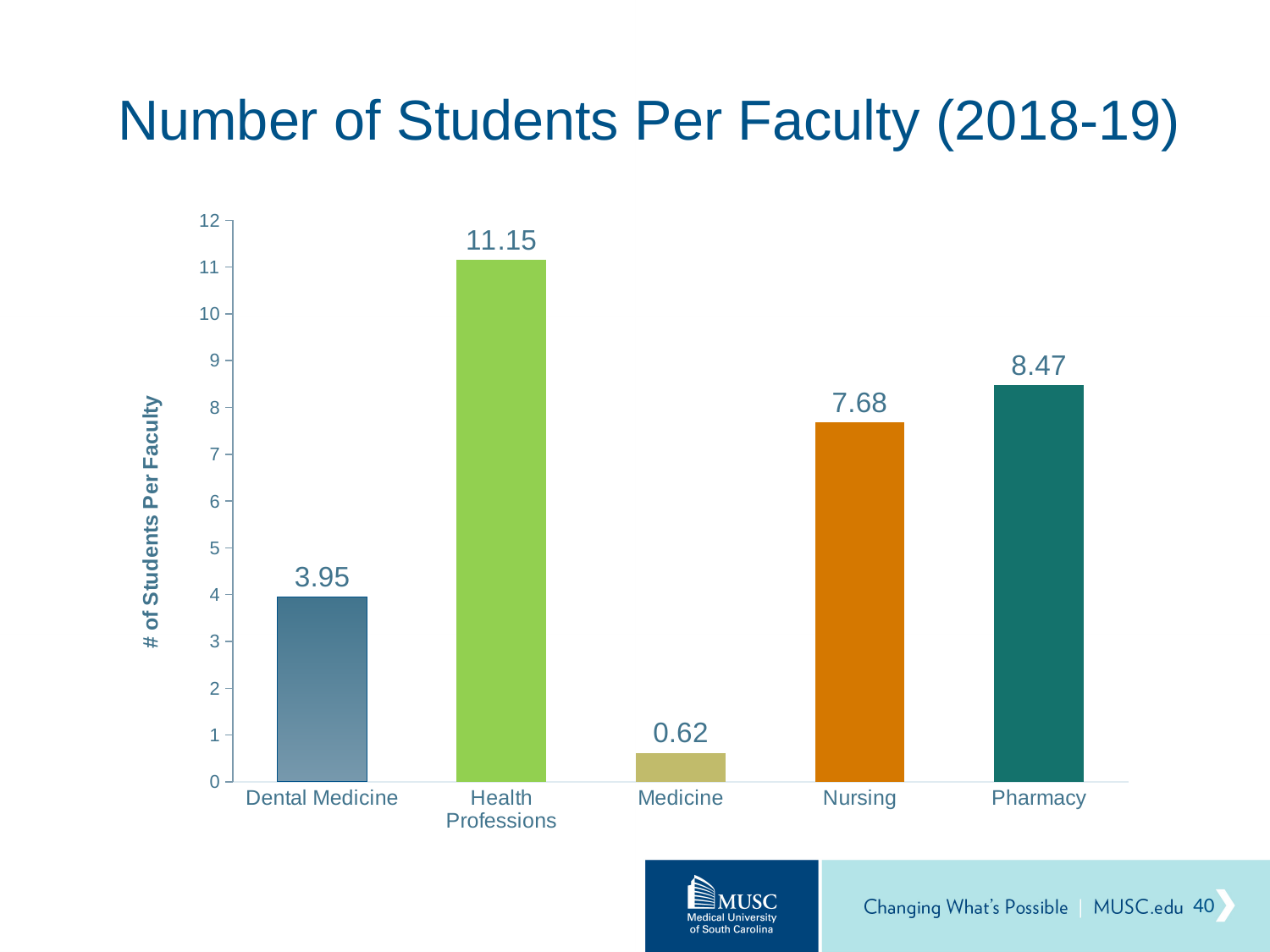
How many colleges are shown on the chart? 5 Is the value for Medicine greater or less than 1? less What is the difference in students per faculty between Health Professions and Dental Medicine? 7.20 Which college has the highest number of students per faculty? Health Professions Which has more students per faculty, Pharmacy or Nursing? Pharmacy What is the number of students per faculty for Nursing? 7.68 Which college has the lowest number of students per faculty? Medicine What is the number of students per faculty for Health Professions? 11.15 What is the difference in students per faculty between Pharmacy and Nursing? 0.79 What kind of chart is shown on the slide? Bar chart What is the title of the chart? Number of Students Per Faculty (2018-19) What is the number of students per faculty for Dental Medicine? 3.95